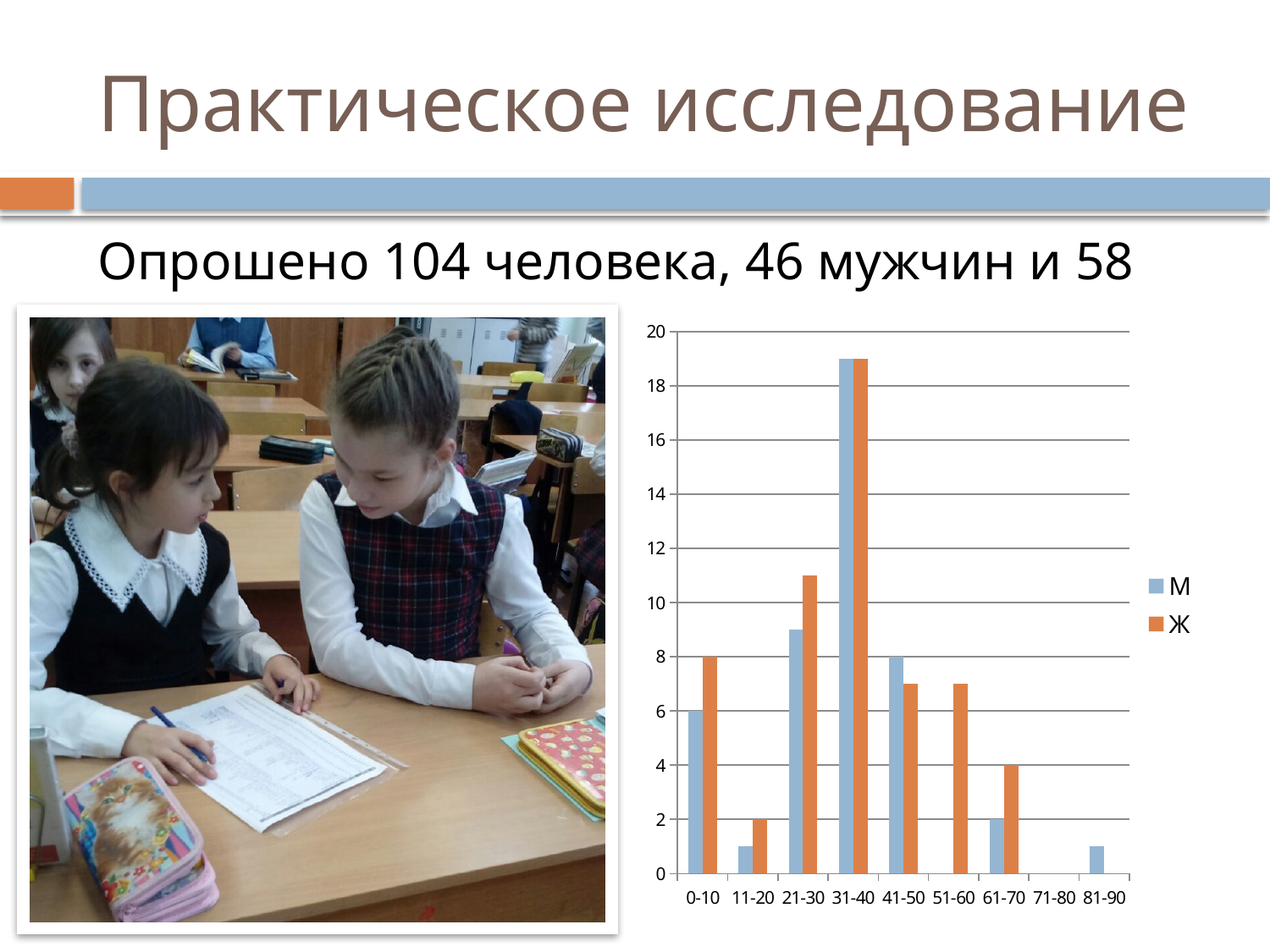
What is the value for Ж in the 0-10 category? 8 What is the difference between the Ж and М values in the 0-10 category? 2 Is the value for М in the 31-40 category greater or less than 18? greater In the 51-60 category, which series has the larger value, М or Ж? Ж What is the value for М in the 0-10 category? 6 How many age categories are shown on the x axis of the chart? 9 Is the value for Ж in the 21-30 category greater or less than 10? greater Which category has the highest value for Ж? 31-40 What is the value for Ж in the 61-70 category? 4 What is the value for М in the 41-50 category? 8 What type of chart is shown on the slide? bar chart How many series does the chart legend list? 2